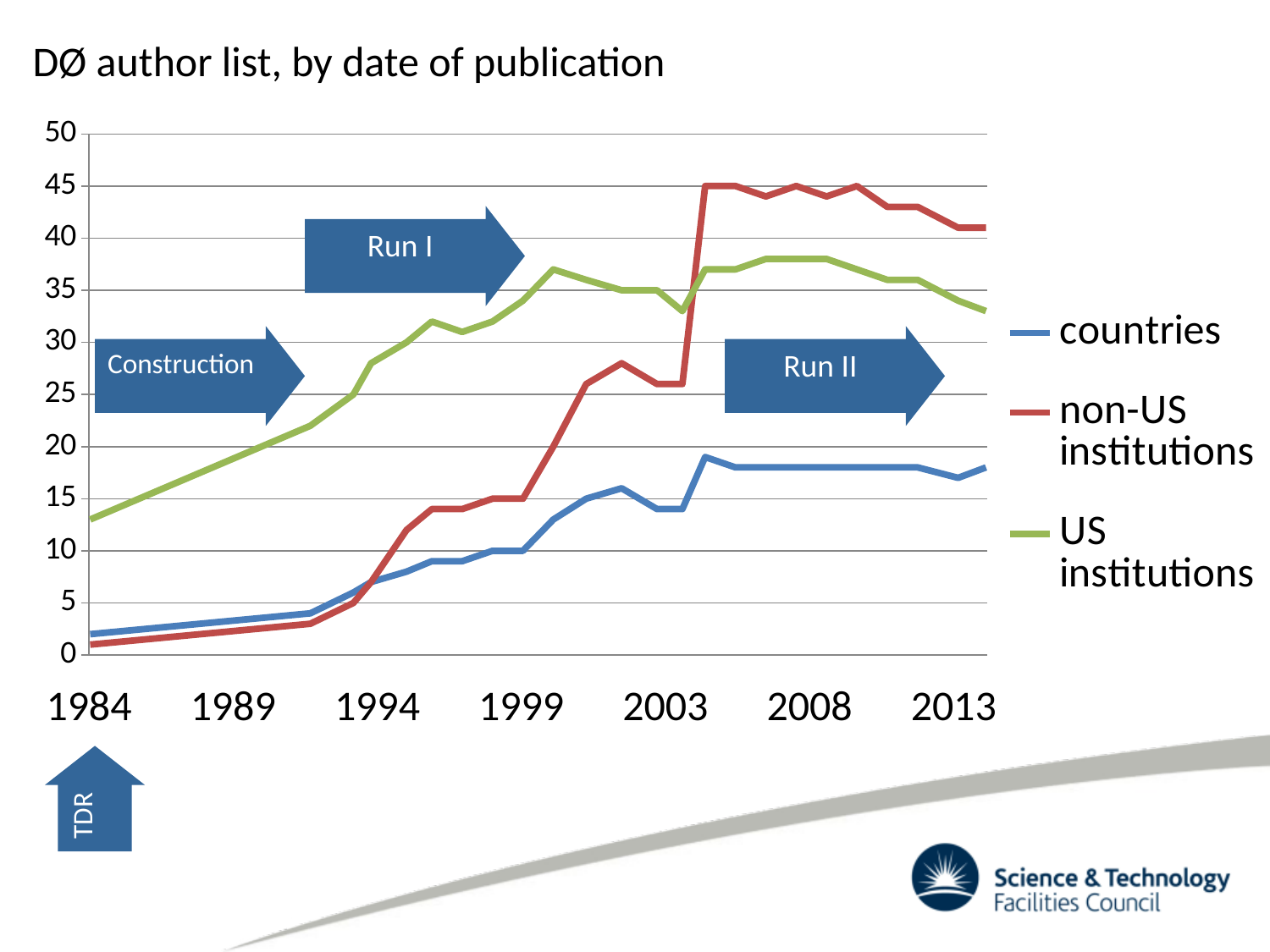
Is the value for US institutions in 1984 greater or less than 10? greater Which series has the lowest value in 1984? non-US institutions Which colour is used for the countries series? blue Is the value for countries in 2013 greater or less than 20? less Does the countries series rise or fall overall from 1984 to 2013? rise Is the value for US institutions in 2013 greater or less than 30? greater What kind of chart is shown on the slide? line chart What is the title of the chart? DØ author list, by date of publication In 2013, which is larger: non-US institutions or US institutions? non-US institutions How many series does the legend list? 3